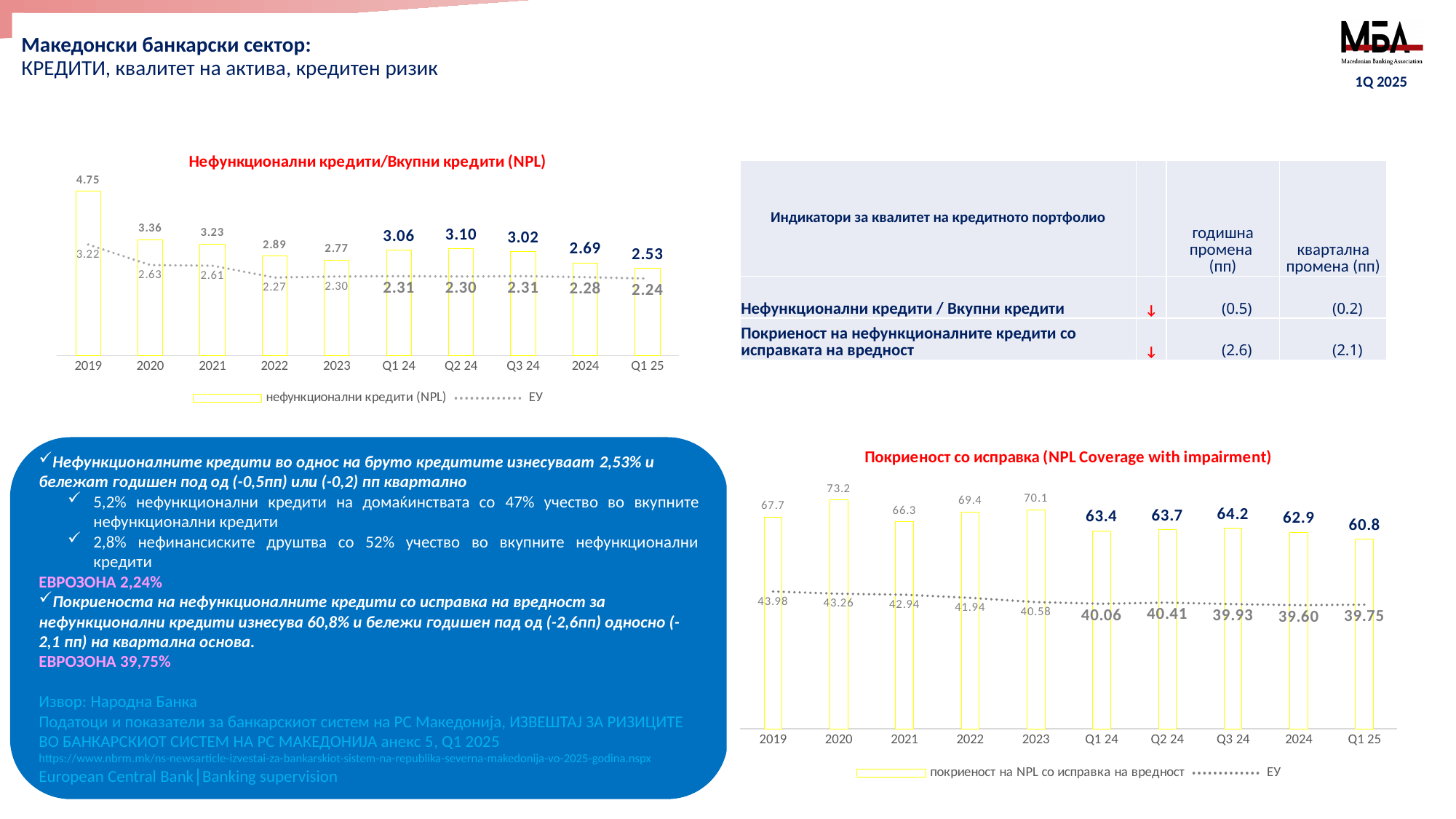
In the chart titled 'Нефункционални кредити/Вкупни кредити (NPL)', what is the NPL value for Q1 25? 2.53 In the chart titled 'Покриеност со исправка (NPL Coverage with impairment)', what is the ЕУ value for 2019? 43.98 In the chart titled 'Покриеност со исправка (NPL Coverage with impairment)', how many categories are shown on the x axis? 10 In the chart titled 'Покриеност со исправка (NPL Coverage with impairment)', which category has the lowest coverage bar? Q1 25 In the chart titled 'Нефункционални кредити/Вкупни кредити (NPL)', what is the difference between the NPL value for 2024 and for Q1 25? 0.16 In the chart titled 'Нефункционални кредити/Вкупни кредити (NPL)', what is the ЕУ value for Q1 25? 2.24 In the chart titled 'Покриеност со исправка (NPL Coverage with impairment)', what kind of chart is used for the 'покриеност на NPL со исправка на вредност' series? Bar chart In the chart titled 'Нефункционални кредити/Вкупни кредити (NPL)', which category has the highest NPL bar? 2019 In the chart titled 'Нефункционални кредити/Вкупни кредити (NPL)', how many series does the legend list? 2 In the chart titled 'Нефункционални кредити/Вкупни кредити (NPL)', what is the NPL value for 2019? 4.75 In the chart titled 'Покриеност со исправка (NPL Coverage with impairment)', what is the coverage value for 2020? 73.2 In the chart titled 'Покриеност со исправка (NPL Coverage with impairment)', is the coverage value for Q3 24 or for 2024 larger? Q3 24